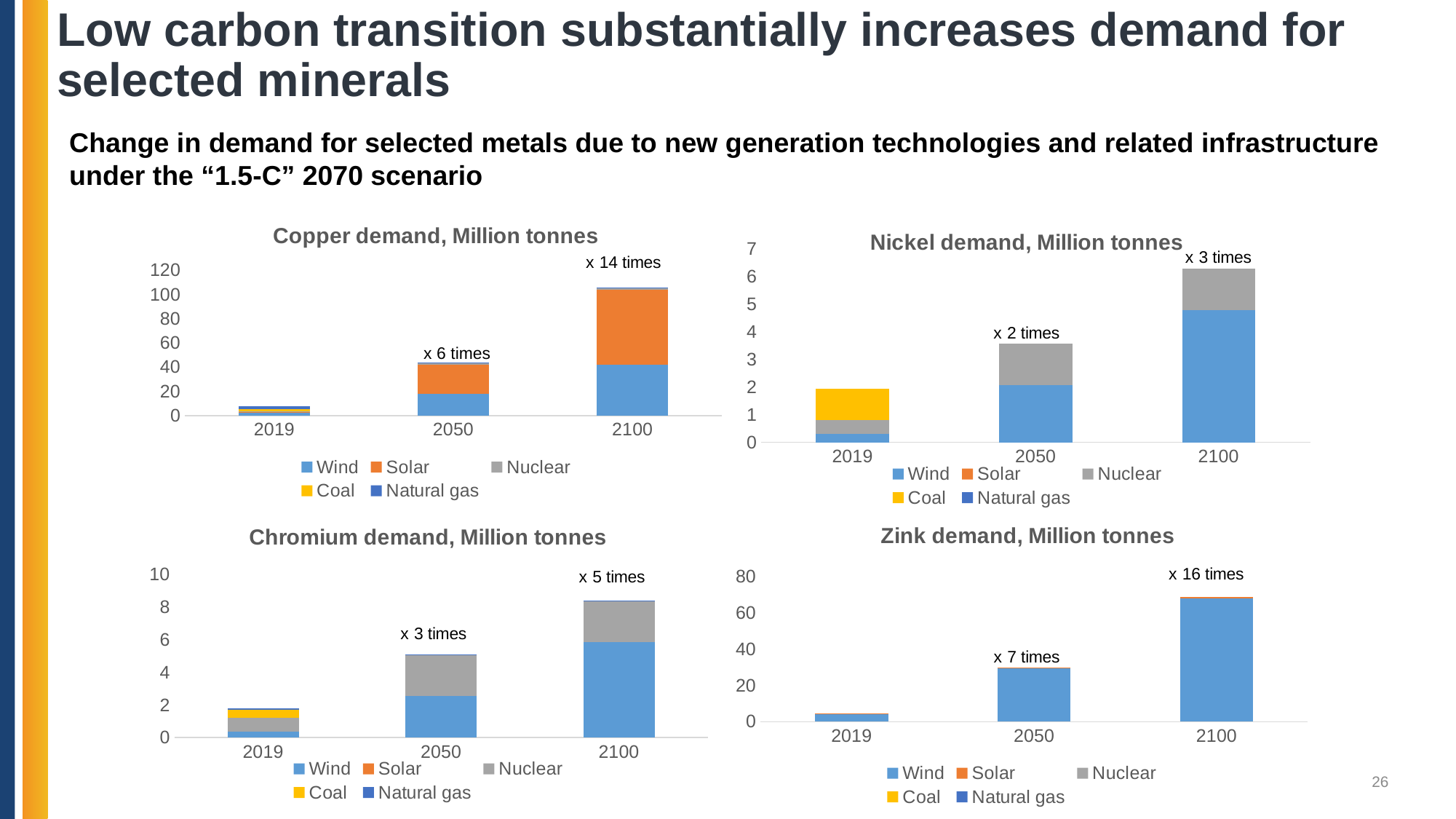
In the Copper demand chart, is the total value for 2050 greater or less than 60? less In the Chromium demand chart, is the total value for 2050 greater or less than 4? greater In the Zink demand chart, what multiplier label is shown above the 2050 bar? x 7 times In the Copper demand chart, what multiplier label is shown above the 2100 bar? x 14 times What kind of chart is the Copper demand chart? stacked bar chart How many series does the legend of the Chromium demand chart list? 5 In the Zink demand chart, which is larger, the total for 2050 or the total for 2100? 2100 How many years (categories) are shown on the x axis of the Nickel demand chart? 3 In the Nickel demand chart, do total values rise or fall from 2019 to 2100? rise In the Copper demand chart, which year has the highest total demand? 2100 In the Nickel demand chart, is the total value for 2100 greater or less than 6? greater In the Zink demand chart, which year has the lowest total demand? 2019